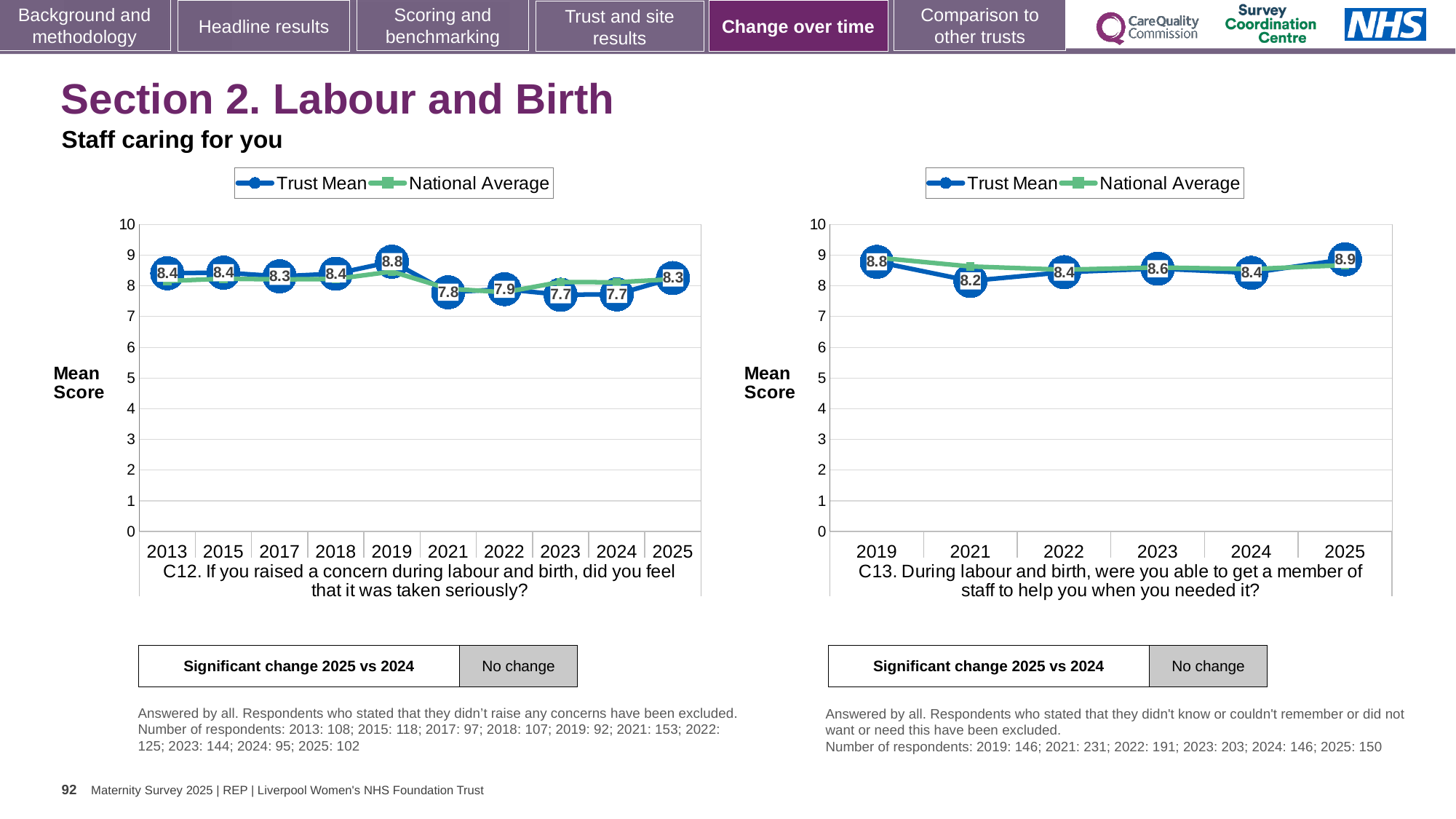
In the C13 chart, which year has the highest Trust Mean? 2025 In the C13 chart, which year has the lowest Trust Mean? 2021 How many series does the legend of the C13 chart list? 2 In the C12 chart, is the Trust Mean for 2021 greater or less than 8? less In the C12 chart, what is the Trust Mean for 2019? 8.8 In the C13 chart, what is the Trust Mean for 2021? 8.2 In the C12 chart, what is the Trust Mean for 2025? 8.3 What type of chart is the C13 chart? Line chart In the C13 chart, is the Trust Mean larger in 2023 or in 2024? 2023 In the C12 chart, what is the difference between the Trust Mean in 2019 and in 2024? 1.1 In the C12 chart, which year has the highest Trust Mean? 2019 In the C12 chart, how many years are shown on the x axis? 10